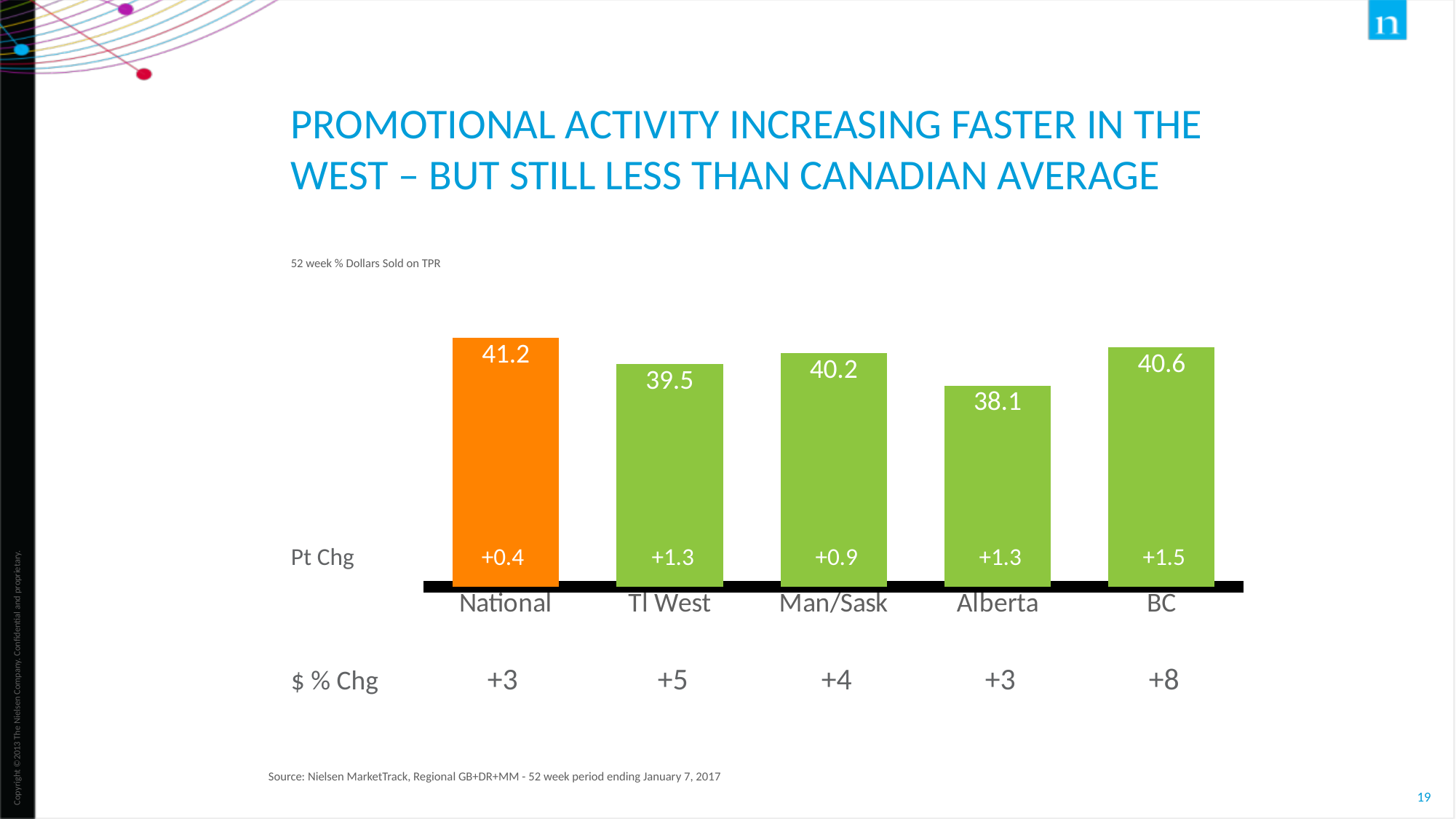
How many categories are shown on the chart? 5 Which category has the lowest bar? Alberta What is the difference between the National value and the Alberta value? 3.1 What is the Pt Chg shown for Tl West? +1.3 What is the value shown for Alberta? 38.1 What is the $ % Chg shown for BC? +8 What kind of chart is shown on the slide? Bar chart Which category has the highest bar? National What is the value shown for BC? 40.6 Which bar is coloured orange rather than green? National What is the 52 week % Dollars Sold on TPR value for National? 41.2 Which is larger, the value for Man/Sask or the value for Tl West? Man/Sask